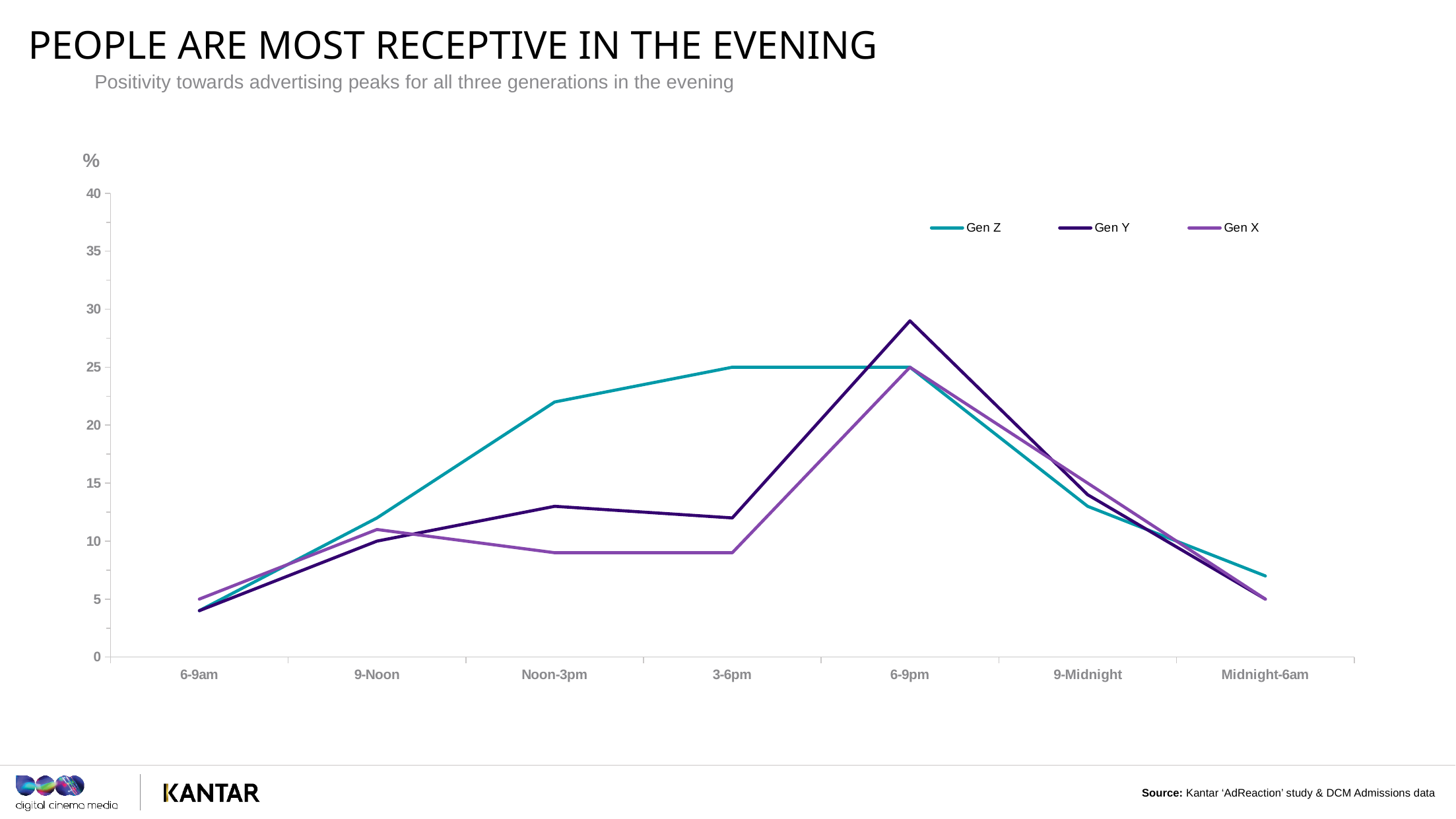
What type of chart is shown on the slide? line chart In which time period does Gen X reach its highest value? 6-9pm How many series does the legend list? 3 Does the Gen Z line rise or fall from 6-9pm to Midnight-6am? fall What is the value for Gen Z at 3-6pm? 25 At Noon-3pm, which is larger: Gen Z or Gen X? Gen Z What is the value for Gen Y at 9-Noon? 10 Is the value for Gen Y at 6-9pm greater or less than 25? greater Is the value for Gen Z at Noon-3pm greater or less than 20? greater What is the value for Gen X at 6-9pm? 25 Which series has the highest value at 6-9pm? Gen Y How many time periods are shown along the x axis? 7